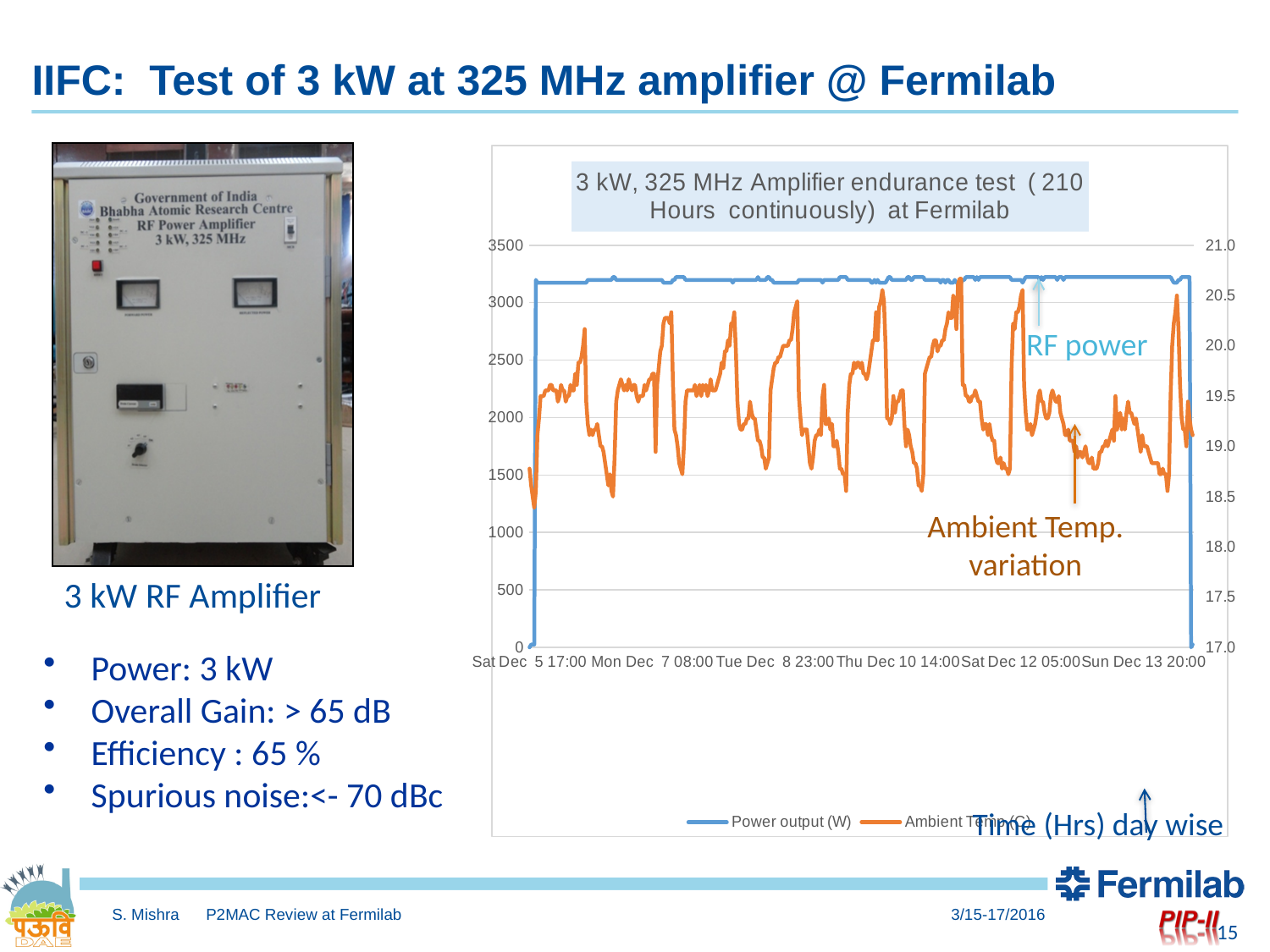
Does the Power output (W) series rise, fall, or stay roughly flat across the test period? stays roughly flat Is the Power output (W) value during the test greater or less than 2500 on the left axis? greater Is the Power output (W) value during the test greater or less than 3000 on the left axis? greater Which series shows large repeated fluctuations over the test period, Power output (W) or Ambient Temp (C)? Ambient Temp (C) How many series does the chart legend list? 2 What kind of chart is shown on the slide? line chart What is the last date label shown on the x axis of the chart? Sun Dec 13 20:00 What is the first date label shown on the x axis of the chart? Sat Dec 5 17:00 What is the maximum value shown on the left vertical axis of the chart? 3500 Is the Power output (W) value during the test greater or less than 3500 on the left axis? less What is the title of the chart? 3 kW, 325 MHz Amplifier endurance test ( 210 Hours continuously) at Fermilab What are the two series named in the chart legend? Power output (W) and Ambient Temp (C)